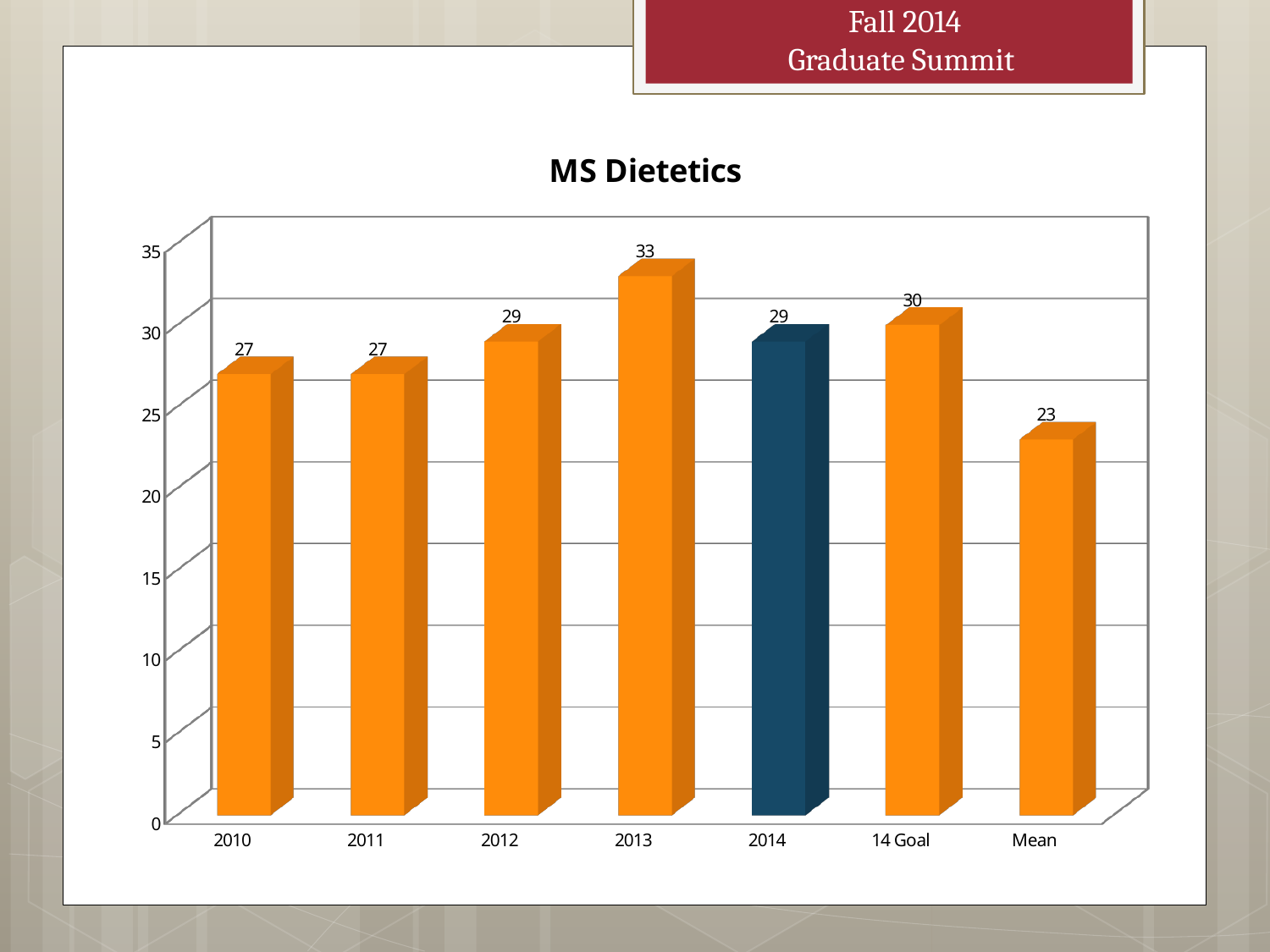
How many categories are shown on the x axis of the MS Dietetics chart? 7 Which bar in the MS Dietetics chart is coloured dark blue instead of orange? 2014 What is the value for 14 Goal in the MS Dietetics chart? 30 What is the value for Mean in the MS Dietetics chart? 23 Is the value for 2012 in the MS Dietetics chart greater or less than 25? greater Which category has the highest value in the MS Dietetics chart? 2013 What kind of chart is shown on the slide? Bar chart What is the value for 2013 in the MS Dietetics chart? 33 What is the difference between the values for 2013 and 2014 in the MS Dietetics chart? 4 What is the value for 2014 in the MS Dietetics chart? 29 Which is larger in the MS Dietetics chart, the value for 2014 or the value for 14 Goal? 14 Goal Which category has the lowest value in the MS Dietetics chart? Mean